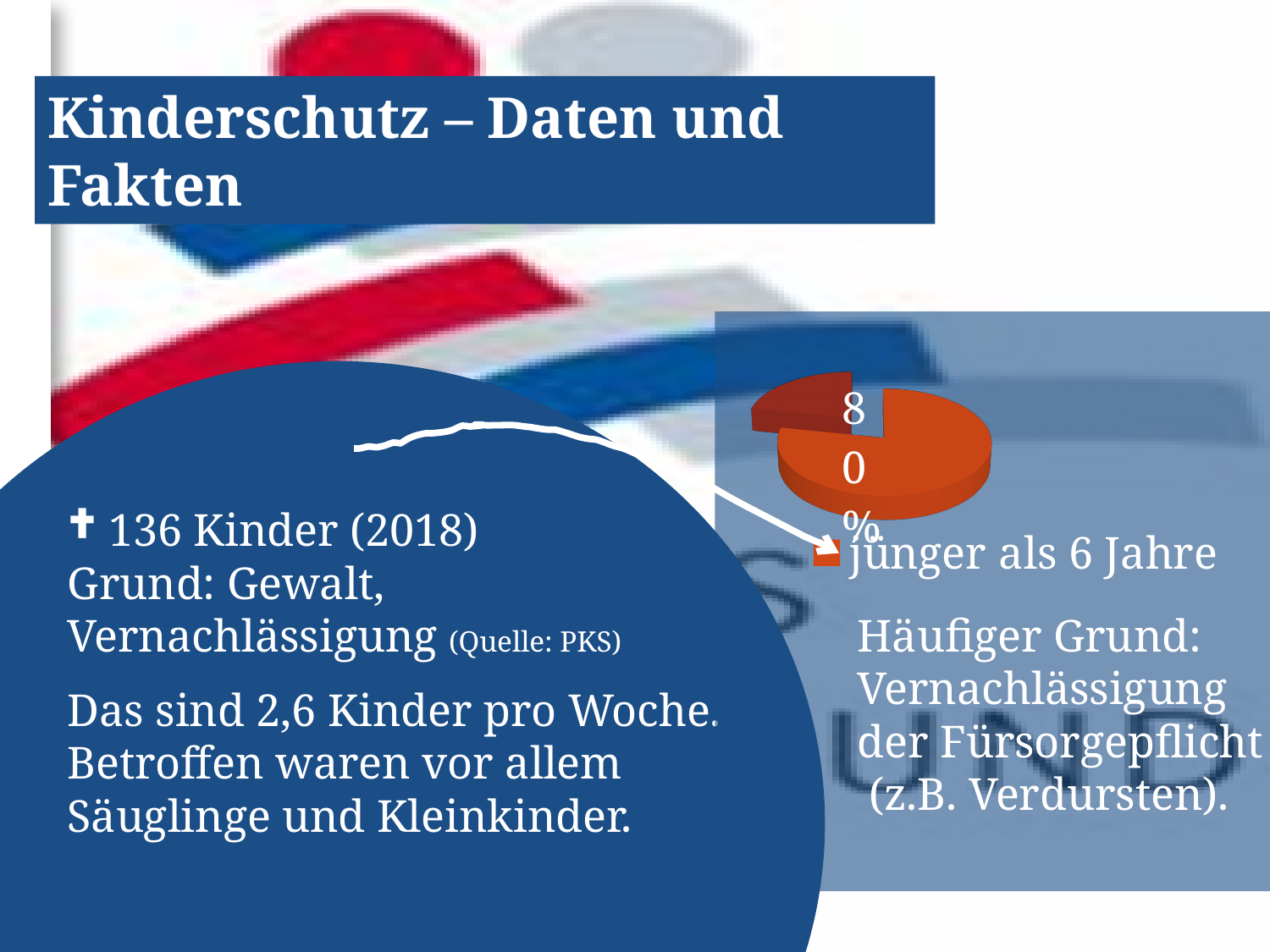
What colour is the large slice of the pie chart? orange-red What kind of chart is shown on the slide? pie chart How many slices does the pie chart have? 2 Is the share of the slice labelled 80% greater or less than 50%? greater What share of the pie does the slice labelled "jünger als 6 Jahre" represent? 80% Which slice of the pie chart is larger, the labelled slice (jünger als 6 Jahre) or the small separated slice? the labelled slice (jünger als 6 Jahre) What is the legend entry shown for the pie chart? jünger als 6 Jahre What percentage is printed as the data label on the pie chart? 80% How many entries does the legend of the pie chart list? 1